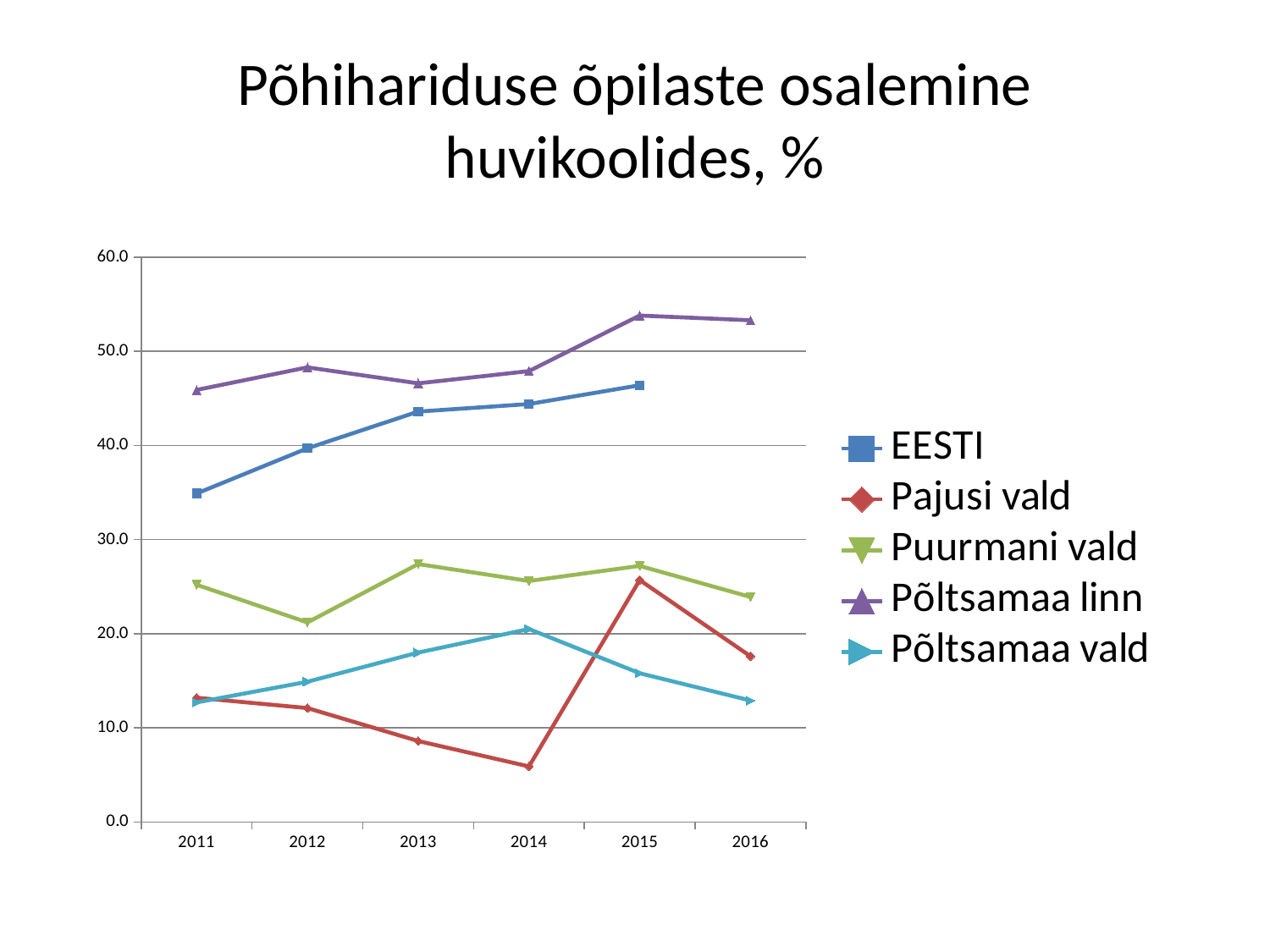
Is the value for EESTI in 2011 greater or less than 40.0? less In which year does Pajusi vald reach its highest value? 2015 Is the value for Põltsamaa linn in 2015 greater or less than 50.0? greater What kind of chart is shown on the slide? line chart In 2016, which is larger: Puurmani vald or Pajusi vald? Puurmani vald Is the value for Pajusi vald in 2014 greater or less than 10.0? less Which series has the lowest value in 2014? Pajusi vald What is the title of the chart? Põhihariduse õpilaste osalemine huvikoolides, % Which series has the highest value in 2015? Põltsamaa linn How many series does the legend list? 5 Does the EESTI series rise or fall from 2011 to 2015? rise How many years are shown on the x axis? 6